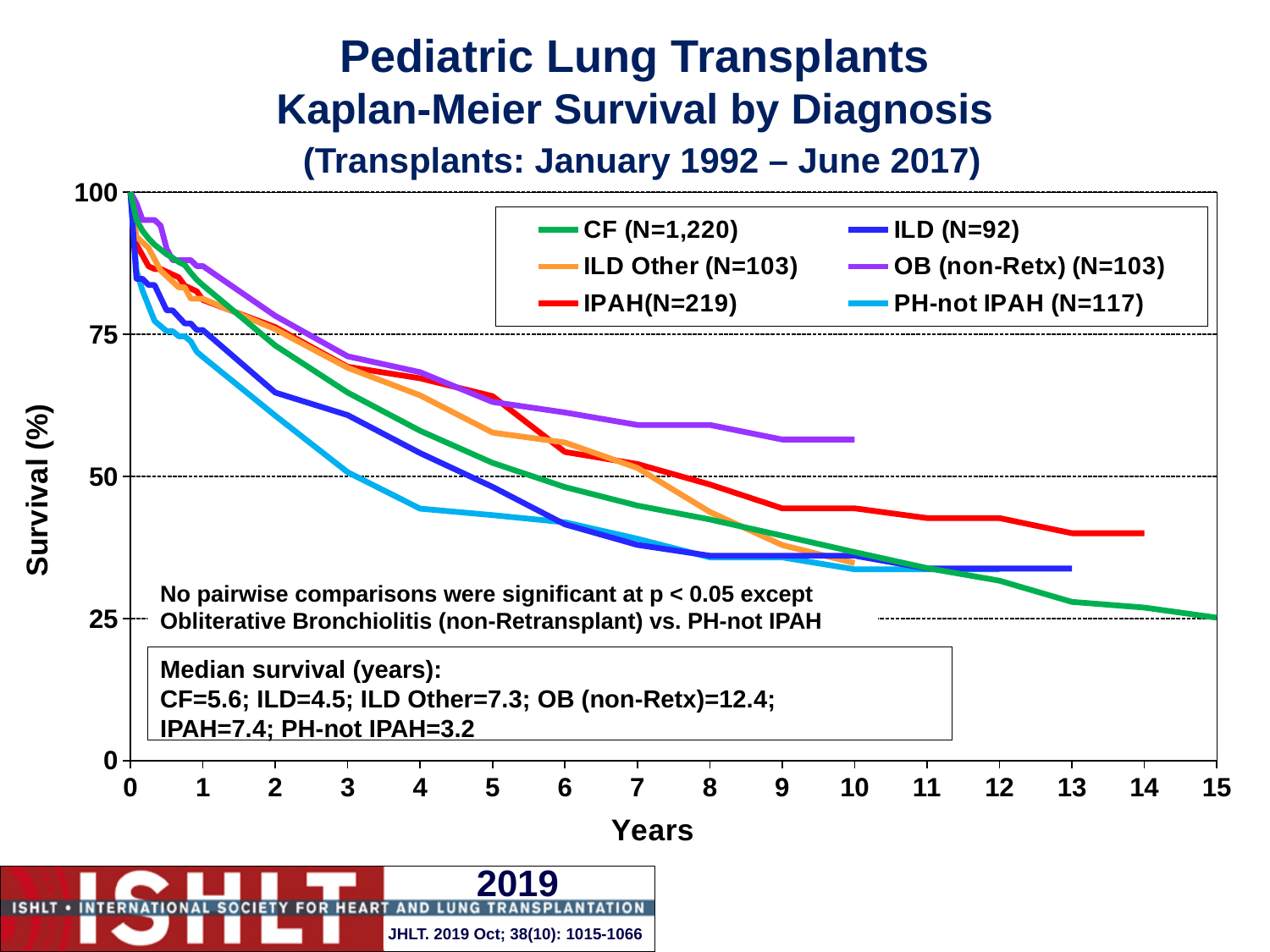
Do the survival curves rise or fall as years increase? fall How many series does the legend list? 6 What is the median survival in years for OB (non-Retx)? 12.4 Is the survival value for OB (non-Retx) at 10 years greater or less than 50? greater Which diagnosis group has the lowest median survival? PH-not IPAH Which diagnosis group has the highest median survival? OB (non-Retx) Which has the larger median survival, IPAH or ILD Other? IPAH What kind of chart is shown on the slide? line chart Is the survival value for PH-not IPAH at 4 years greater or less than 50? less What is the N for the CF group shown in the legend? 1,220 What is the difference in median survival (years) between OB (non-Retx) and PH-not IPAH? 9.2 What is the median survival in years for CF? 5.6